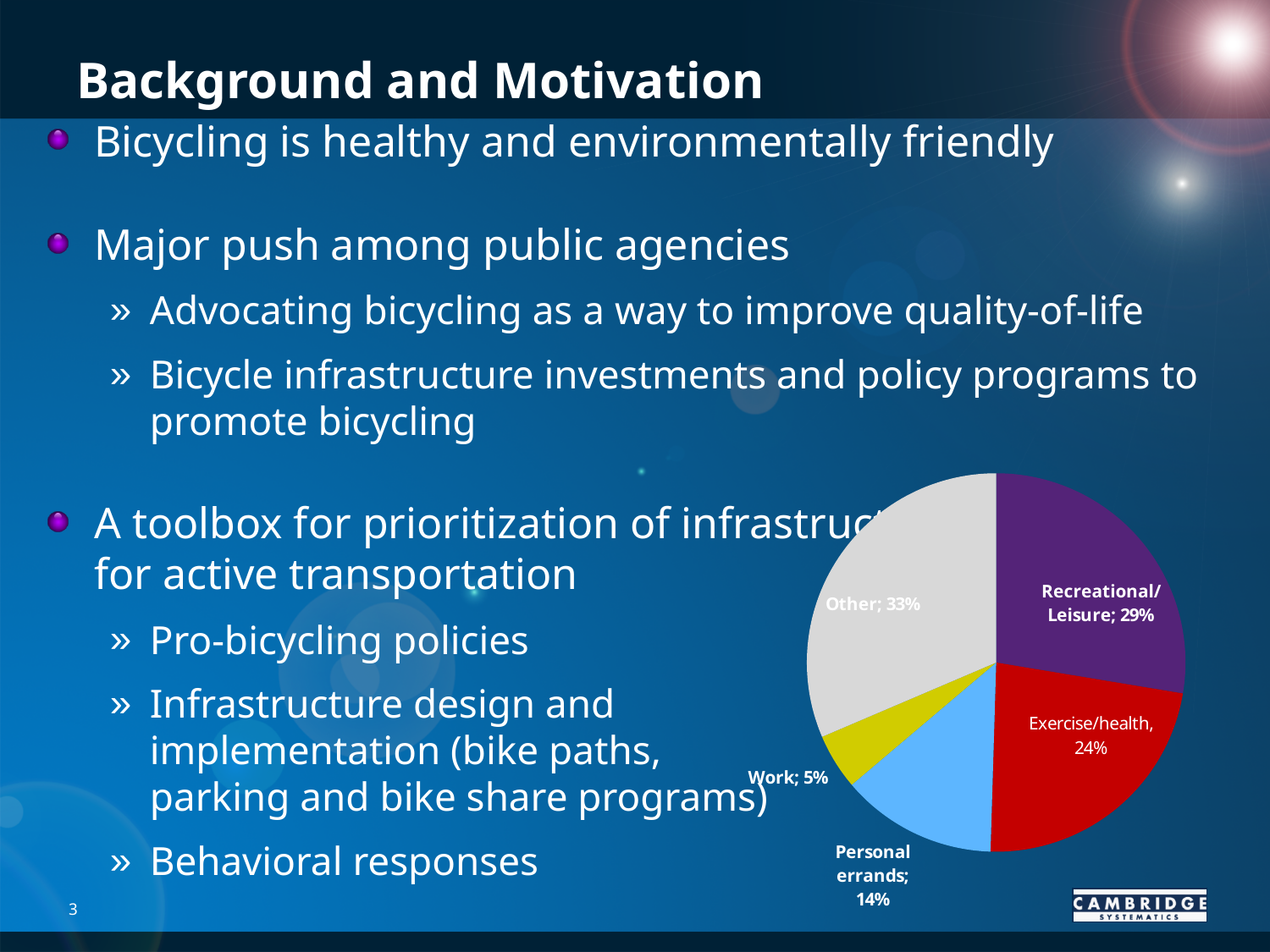
What is the difference in percentage points between the Recreational/Leisure and Exercise/health slices? 5 What share of the pie chart is Exercise/health? 24% What kind of chart is shown on the slide? pie chart What share of the pie chart is Work? 5% What share of the pie chart is Recreational/Leisure? 29% What colour is the Exercise/health slice of the pie chart? red Which slice of the pie chart is the largest? Other Which is larger in the pie chart, Personal errands or Work? Personal errands How many slices does the pie chart have? 5 Which slice of the pie chart is the smallest? Work